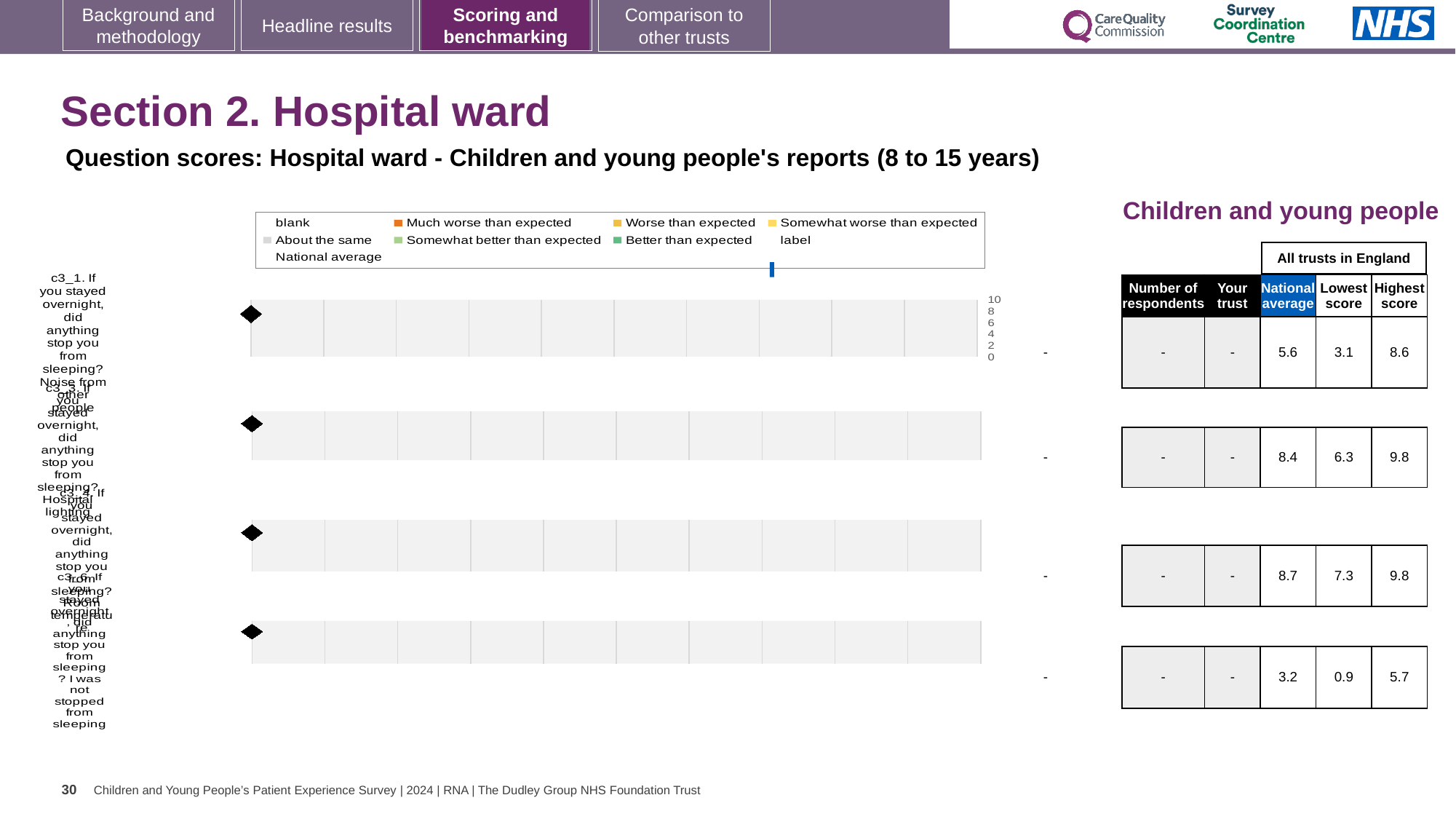
How many entries does the legend above the charts list? 9 In the table next to the charts, what is the Lowest score for the third row (room temperature)? 7.3 Which row in the table has the highest National average? c3_4 (room temperature), 8.7 What is the difference between the Highest score and Lowest score in the first table row? 5.5 In the table next to the charts, what is the National average for the fourth row (I was not stopped from sleeping)? 3.2 In the table next to the charts, what is the Highest score for the second row (hospital lighting)? 9.8 Which row in the table has the lowest National average? c3_6 (I was not stopped from sleeping), 3.2 How many separate chart rows are plotted on the slide? 4 What is the highest tick value shown on the chart axis? 10 In the table next to the charts, what is the National average for the first row (noise from other people)? 5.6 Is the National average for the second table row (hospital lighting) larger or smaller than that for the first row (noise from other people)? larger What kind of chart is used for the question scores on this slide? bar chart